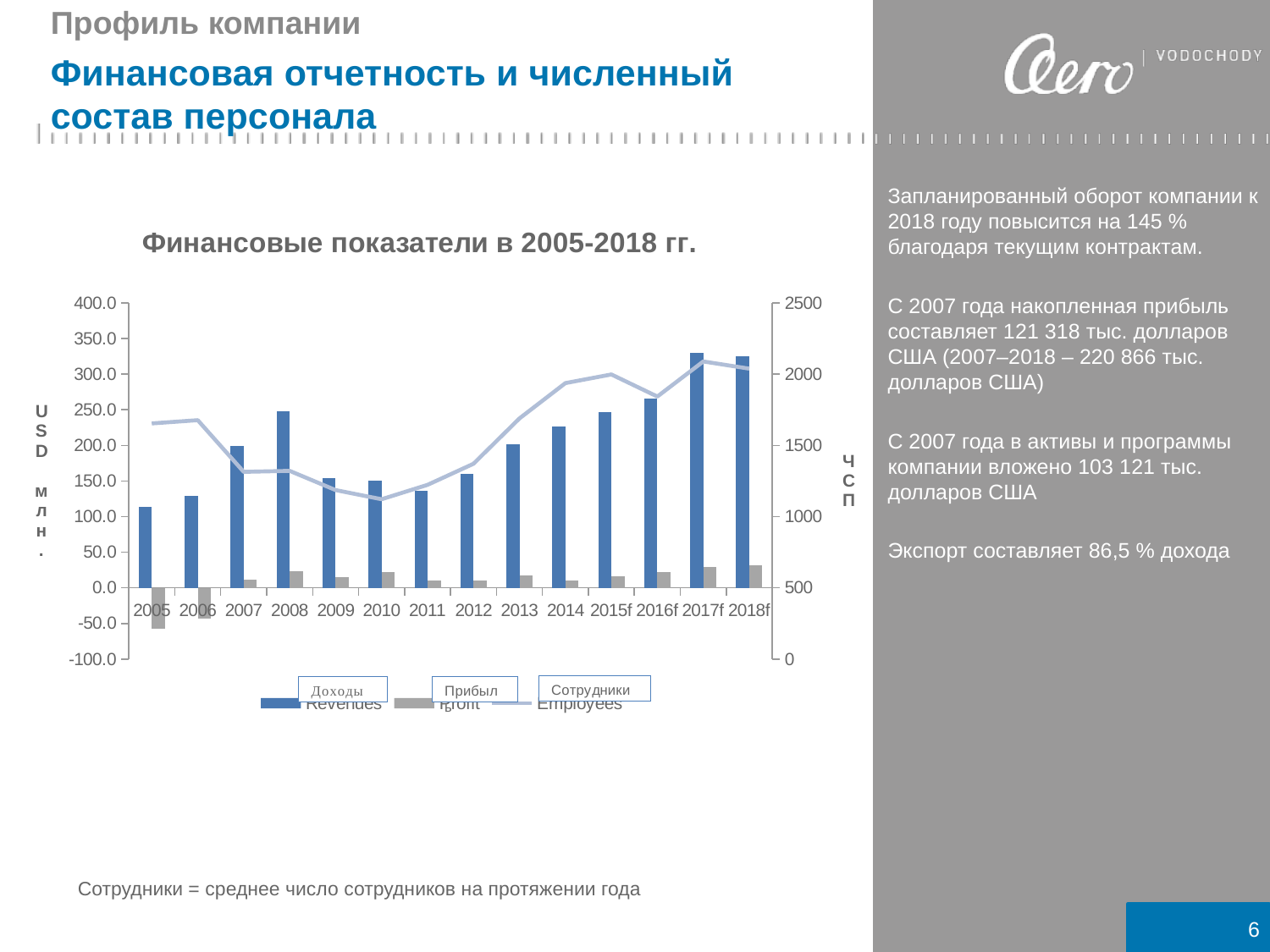
Do the Revenues bars rise or fall from 2013 to 2017f? rise Is the Revenues value for 2017f greater or less than 300? greater Which year has the larger Revenues value, 2008 or 2009? 2008 Which year has the lowest Revenues bar? 2005 What kind of chart is 'Финансовые показатели в 2005-2018 гг.'? Combination bar and line chart Is the Revenues value for 2008 greater or less than 200? greater Which year has the lowest point on the Employees line? 2010 Is the Employees value for 2010 greater or less than 1500? less How many series does the legend of the chart 'Финансовые показатели в 2005-2018 гг.' list? 3 How many years (categories) are shown on the x axis of the chart? 14 Which year has the lowest Profit value? 2005